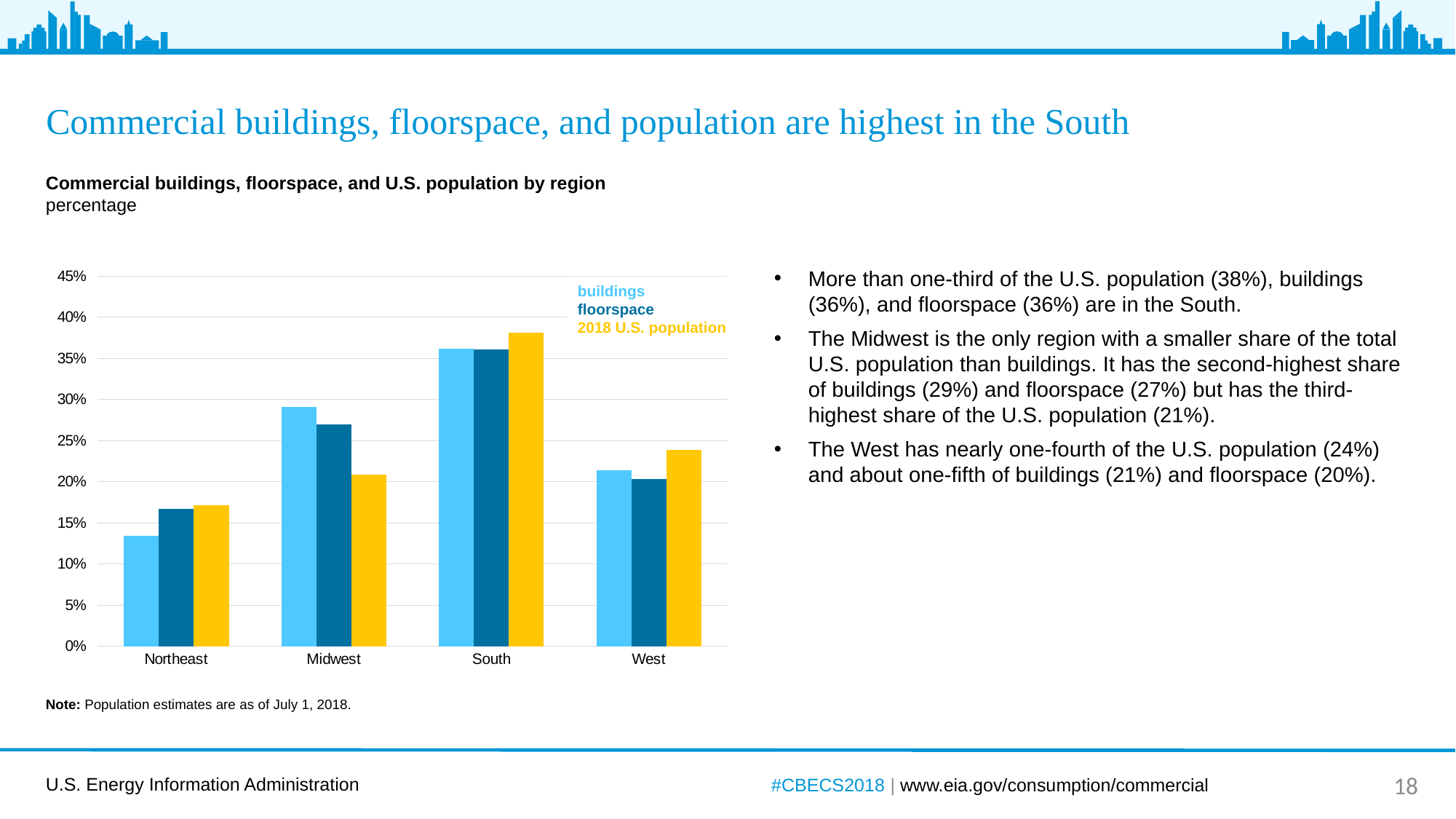
Is the 2018 U.S. population value for the West greater or less than 20%? greater What share of buildings is in the Midwest? 29% In the Midwest, which is larger: the share of buildings or the share of 2018 U.S. population? buildings What share of floorspace is in the West? 20% What is the difference between the Midwest's share of buildings and its share of 2018 U.S. population? 8 percentage points Is the buildings value for the Northeast greater or less than 15%? less Which region has the highest share of 2018 U.S. population? South How many regions are shown on the x axis of the chart? 4 What kind of chart is shown on the slide? bar chart Which region has the lowest share of buildings? Northeast What share of the 2018 U.S. population is in the South? 38% How many series does the chart's legend list? 3